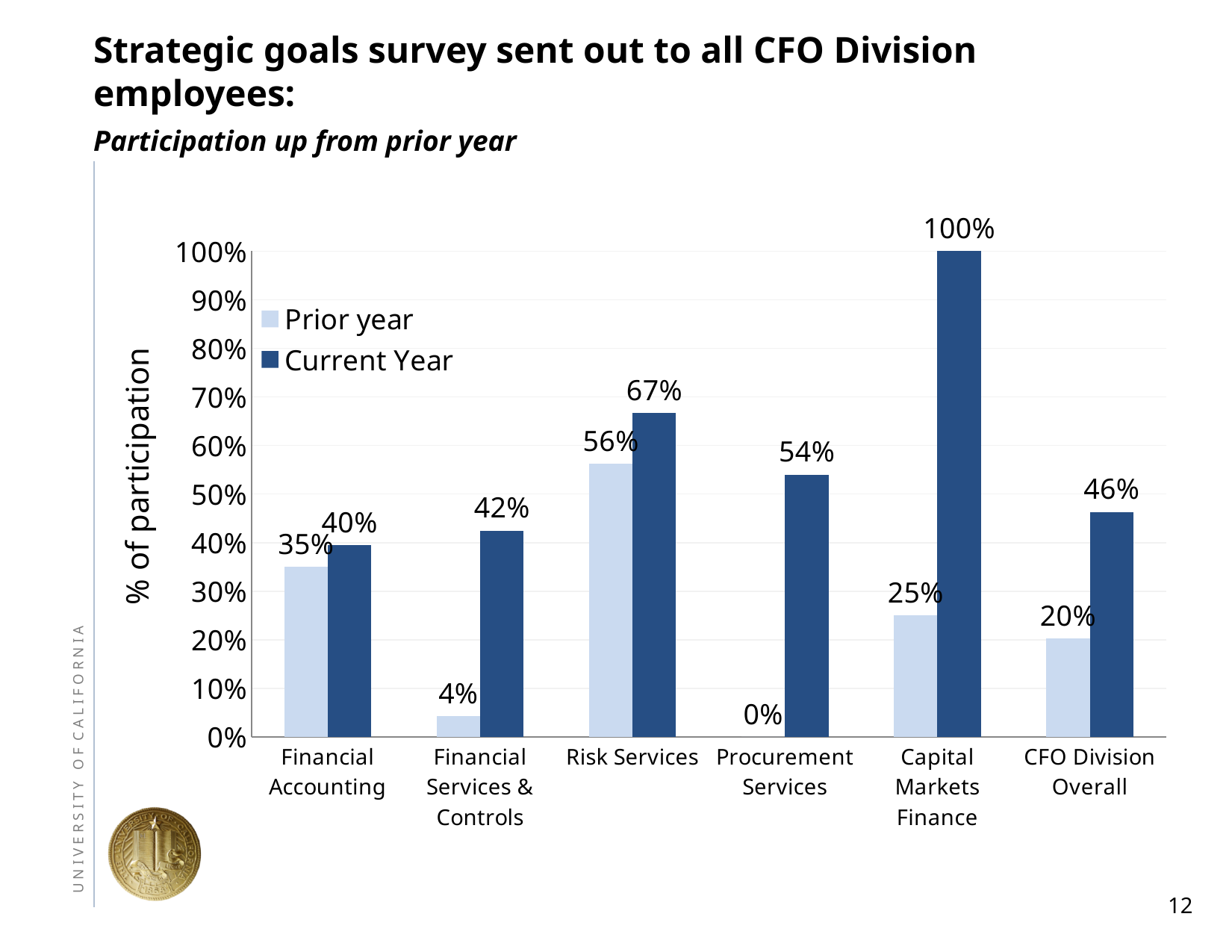
What is the difference between the Current Year and Prior year participation for Financial Services & Controls? 38% How many categories are shown on the x axis? 6 Which category has the highest Current Year participation? Capital Markets Finance Which is larger for Risk Services: the Prior year value or the Current Year value? Current Year What is the Prior year participation value for Procurement Services? 0% What is the Current Year participation value for Capital Markets Finance? 100% What is the label of the y axis? % of participation What kind of chart is shown on the slide? Bar chart What is the Prior year participation value for Risk Services? 56% How many series does the legend list? 2 Which category has the lowest Prior year participation? Procurement Services What is the Current Year participation value for CFO Division Overall? 46%